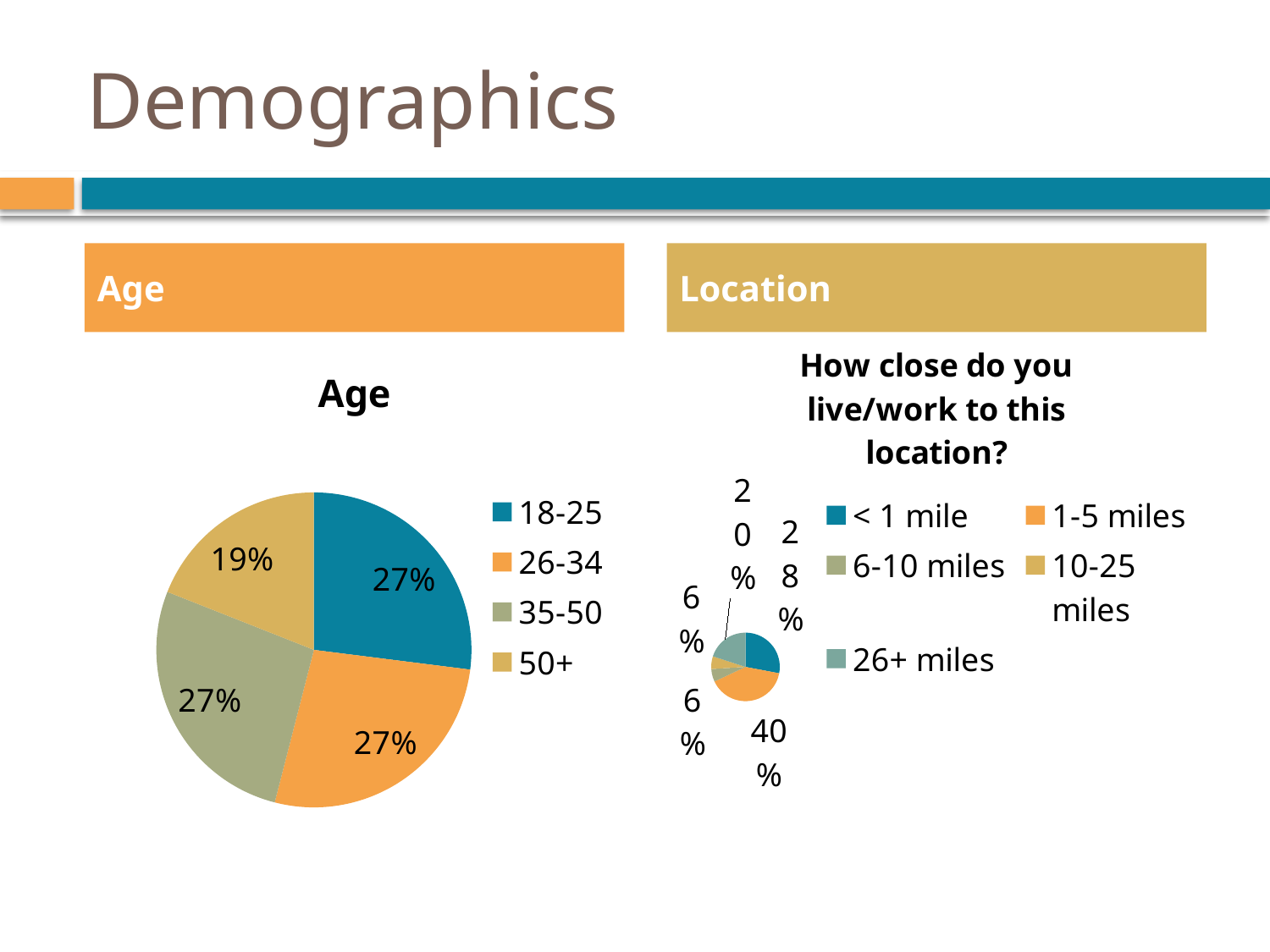
On the 'How close do you live/work to this location?' chart, what percentage is shown for < 1 mile? 28% On the 'How close do you live/work to this location?' chart, which category has the largest share? 1-5 miles On the Age chart, how many age categories are shown? 4 On the Age chart, what percentage is shown for the 18-25 category? 27% On the 'How close do you live/work to this location?' chart, what percentage is shown for 6-10 miles? 6% How many categories does the legend of the 'How close do you live/work to this location?' chart list? 5 On the Age chart, what percentage is shown for the 50+ category? 19% On the Age chart, is the share for 35-50 larger or smaller than the share for 50+? larger On the 'How close do you live/work to this location?' chart, what percentage is shown for 1-5 miles? 40% On the Age chart, which age group has the smallest share? 50+ On the Age chart, what is the difference between the 26-34 share and the 50+ share? 8% What type of chart is the Age chart? pie chart